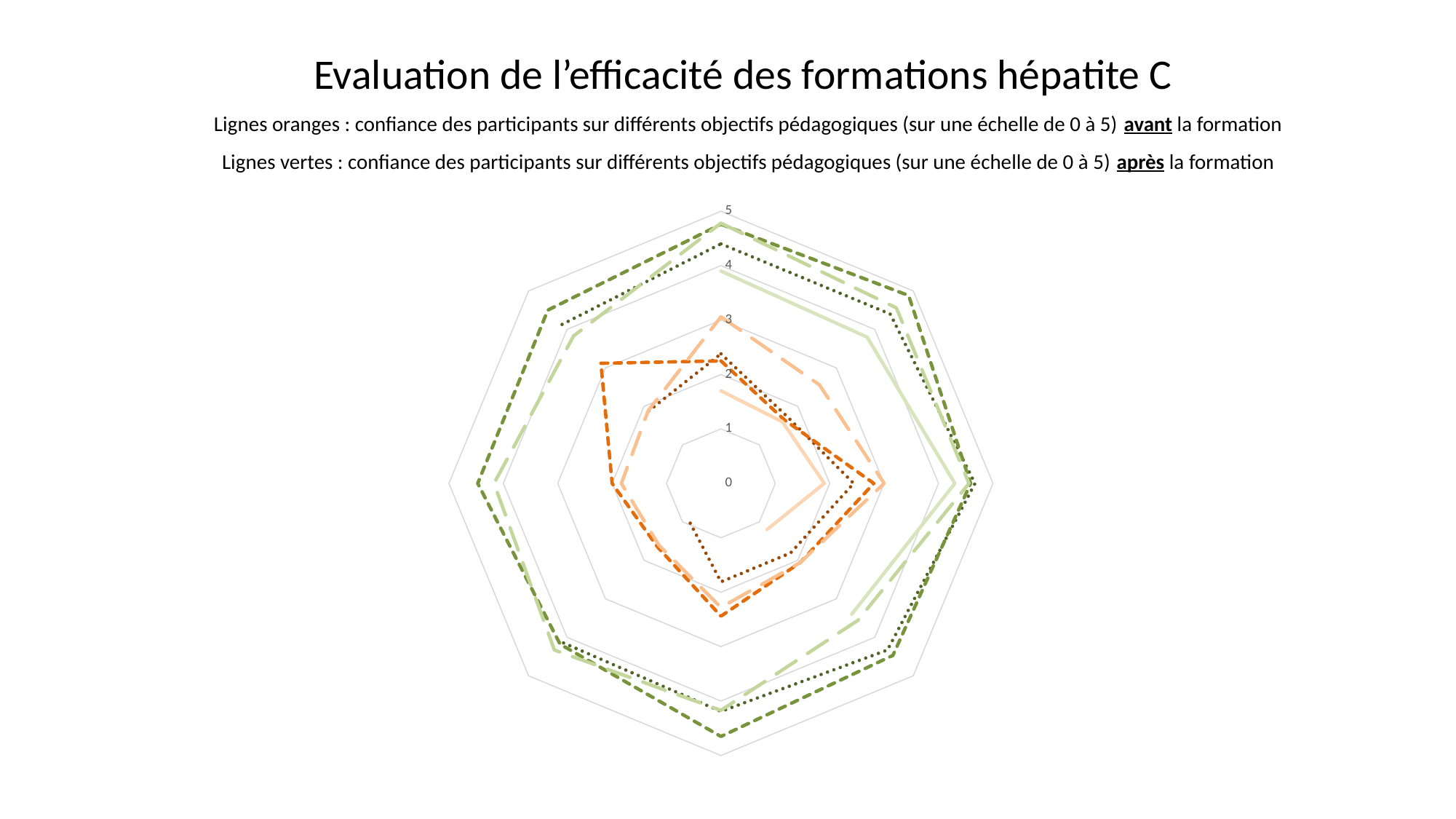
What is the title of the slide's chart? Evaluation de l'efficacité des formations hépatite C Which group of lines, orange or green, lies farther from the centre of the radar chart? green How many axes (spokes) does the radar chart have? 8 According to the slide text, what do the orange lines represent? Participants' confidence on the learning objectives before the training (avant la formation) What is the lowest value labelled on the radar chart's scale? 0 Are the green lines' values greater or less than 3 on every axis? greater What kind of chart is shown on the slide? radar chart Are the orange lines' values greater or less than 4 on every axis? less What is the highest value labelled on the radar chart's scale? 5 Do the values rise or fall from the orange (before training) lines to the green (after training) lines? rise